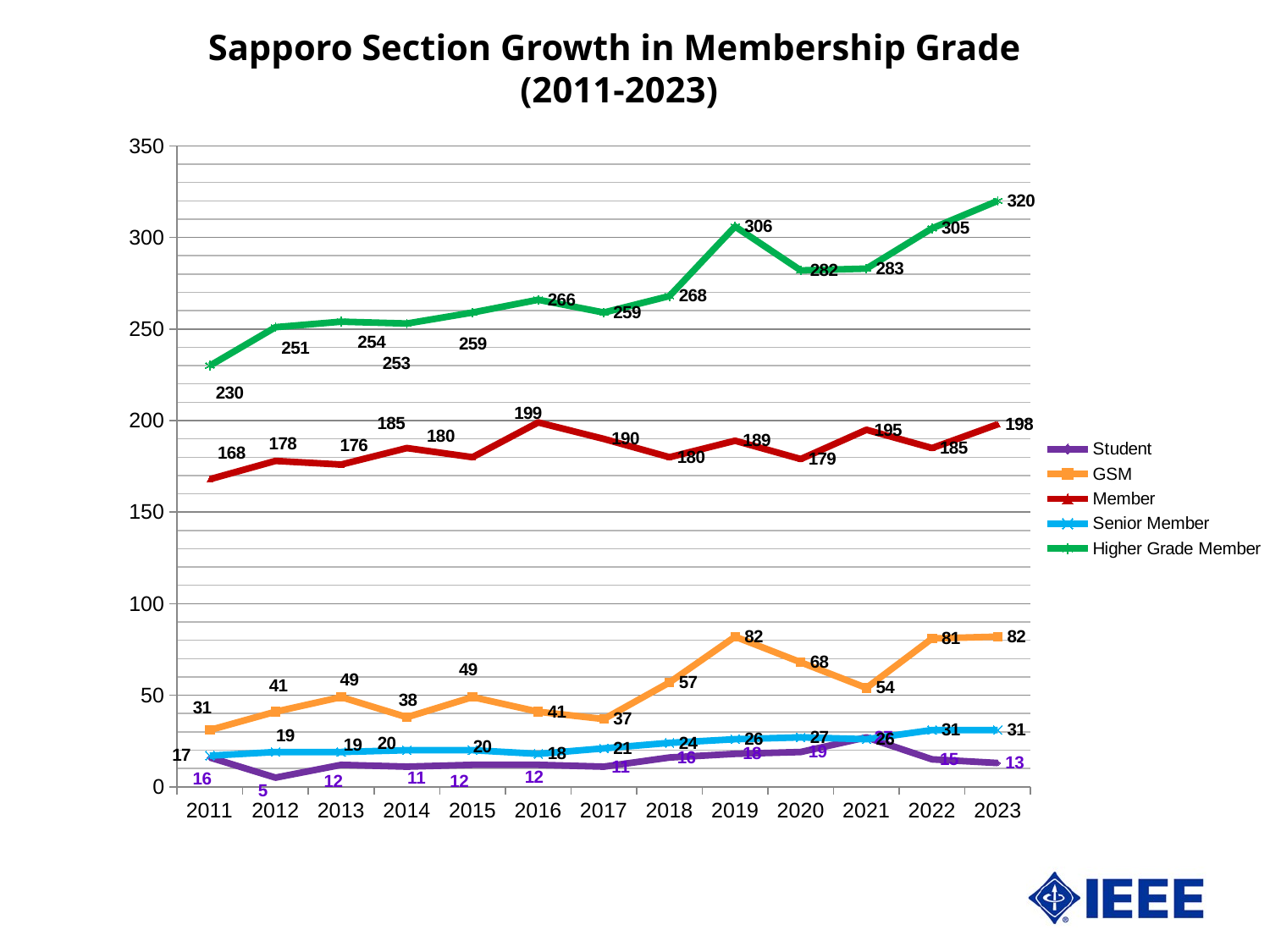
How many series does the legend list? 5 In which year is the Higher Grade Member value highest? 2023 What is the Higher Grade Member value in 2023? 320 Is the Member value in 2011 greater or less than 150? greater By how much did the Higher Grade Member value increase from 2011 to 2023? 90 Does the Higher Grade Member line generally rise or fall from 2011 to 2023? Rise In which year is the Student value lowest? 2012 What is the GSM value in 2019? 82 What kind of chart is shown on the slide? Line chart What is the Senior Member value in 2022? 31 How many years are plotted along the x axis? 13 Which year has the larger GSM value, 2013 or 2014? 2013